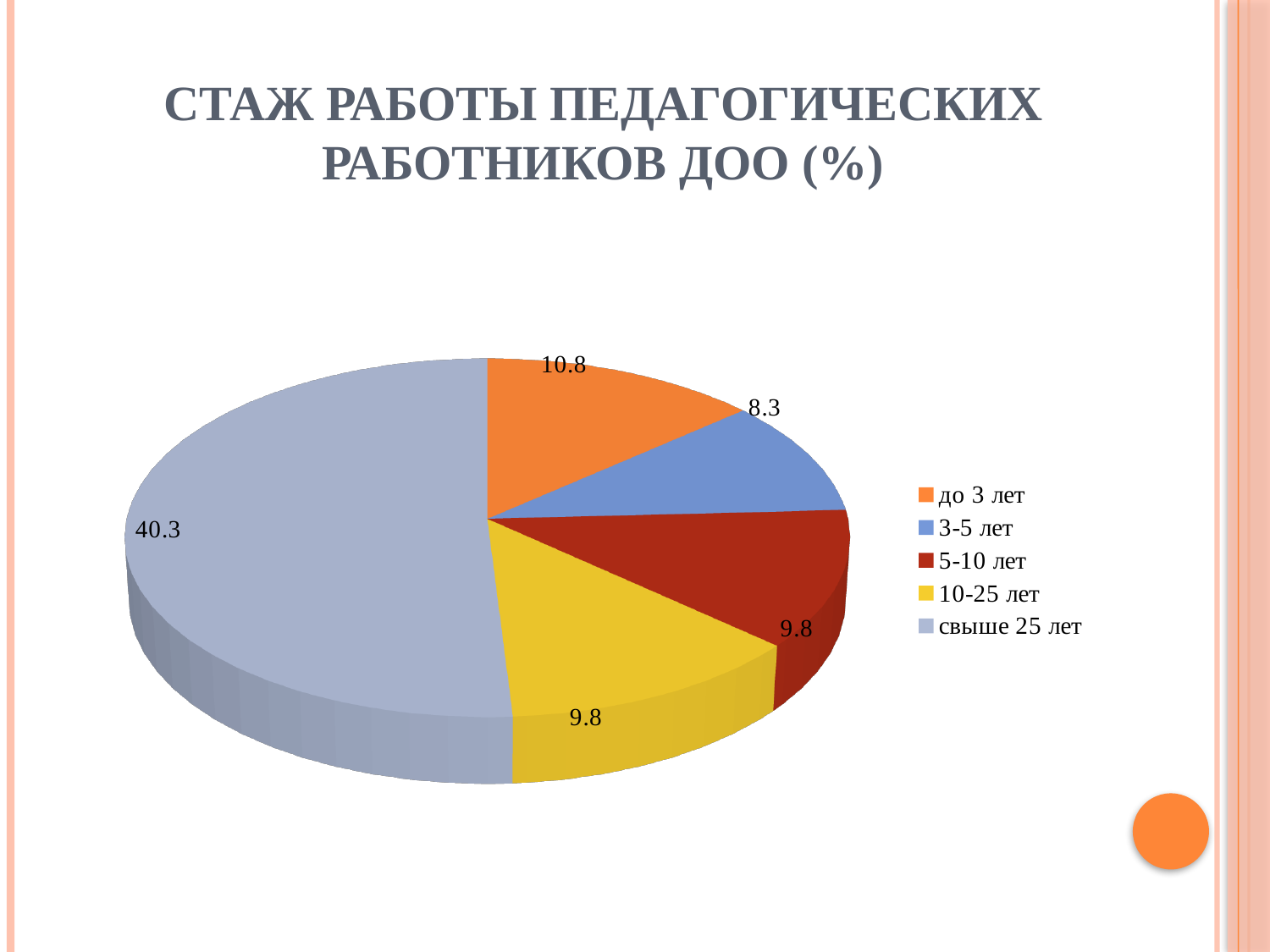
What is the value shown for the "свыше 25 лет" slice? 40.3 What is the value shown for the "5-10 лет" slice? 9.8 What is the value shown for the "до 3 лет" slice? 10.8 Which category has the smallest labelled value? 3-5 лет Which colour represents the "10-25 лет" category in the legend? yellow What is the title of the chart on the slide? СТАЖ РАБОТЫ ПЕДАГОГИЧЕСКИХ РАБОТНИКОВ ДОО (%) Which category has the largest slice of the pie? свыше 25 лет Which is larger, the value for "до 3 лет" or the value for "3-5 лет"? до 3 лет What kind of chart is shown on the slide? pie chart What is the value shown for the "3-5 лет" slice? 8.3 How many categories does the pie chart have? 5 What is the difference between the values for "свыше 25 лет" and "до 3 лет"? 29.5